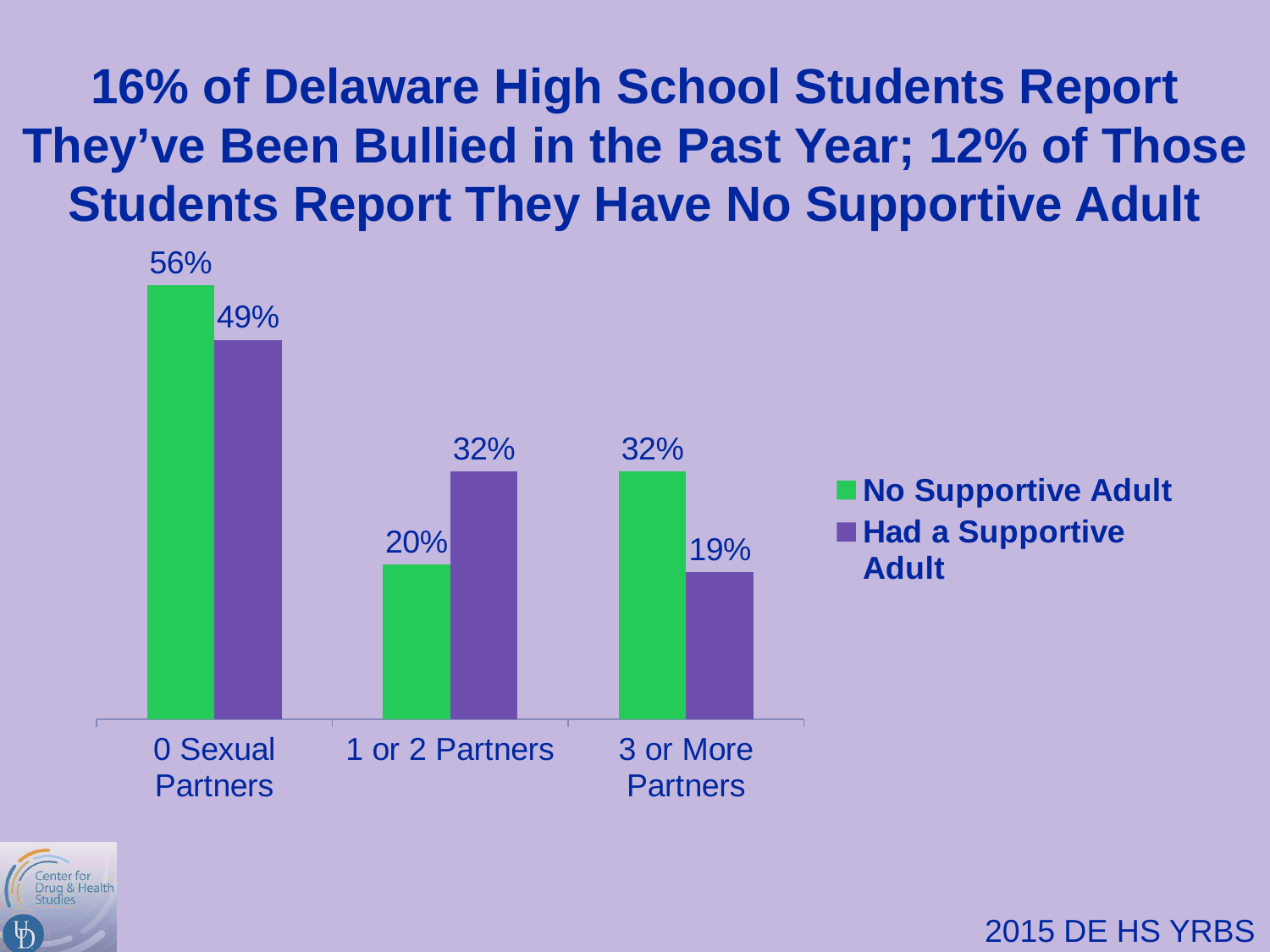
What is the difference between the No Supportive Adult and Had a Supportive Adult values in the 0 Sexual Partners category? 7% What is the value for No Supportive Adult in the 1 or 2 Partners category? 20% What is the value for Had a Supportive Adult in the 3 or More Partners category? 19% In the 1 or 2 Partners category, which series has the larger value? Had a Supportive Adult How many series does the legend list? 2 Which category has the lowest value for the Had a Supportive Adult series? 3 or More Partners What is the value for No Supportive Adult in the 0 Sexual Partners category? 56% Which category has the highest value for the No Supportive Adult series? 0 Sexual Partners In the 3 or More Partners category, which series has the larger value? No Supportive Adult How many categories are shown on the x axis? 3 What kind of chart is shown on the slide? Bar chart What is the value for Had a Supportive Adult in the 1 or 2 Partners category? 32%